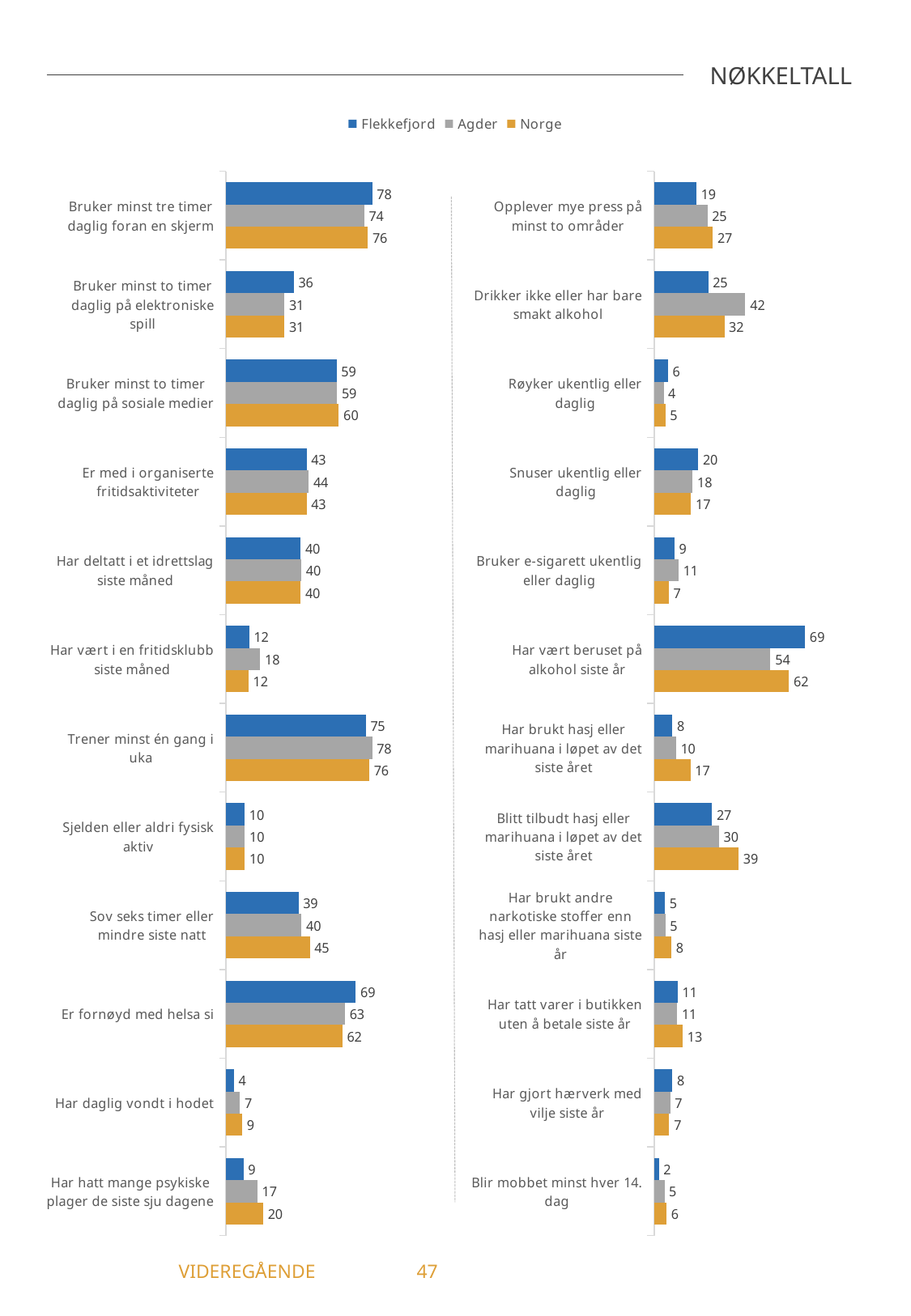
On the left chart, which category has the highest Flekkefjord value? Bruker minst tre timer daglig foran en skjerm On the right chart, what is the difference between the Flekkefjord and Agder values for 'Har vært beruset på alkohol siste år'? 15 On the left chart, what is the Flekkefjord value for 'Bruker minst tre timer daglig foran en skjerm'? 78 On the left chart, which is larger for 'Sov seks timer eller mindre siste natt': the Flekkefjord value or the Norge value? Norge On the right chart, which is larger for 'Opplever mye press på minst to områder': the Flekkefjord value or the Agder value? Agder On the left chart, what is the difference between the Norge and Flekkefjord values for 'Har hatt mange psykiske plager de siste sju dagene'? 11 What kind of chart is shown on the slide? Bar chart On the right chart, what is the Agder value for 'Drikker ikke eller har bare smakt alkohol'? 42 On the right chart, which category has the lowest Flekkefjord value? Blir mobbet minst hver 14. dag How many categories are shown on the left chart? 12 On the right chart, what is the Norge value for 'Blitt tilbudt hasj eller marihuana i løpet av det siste året'? 39 How many series does the legend list? 3